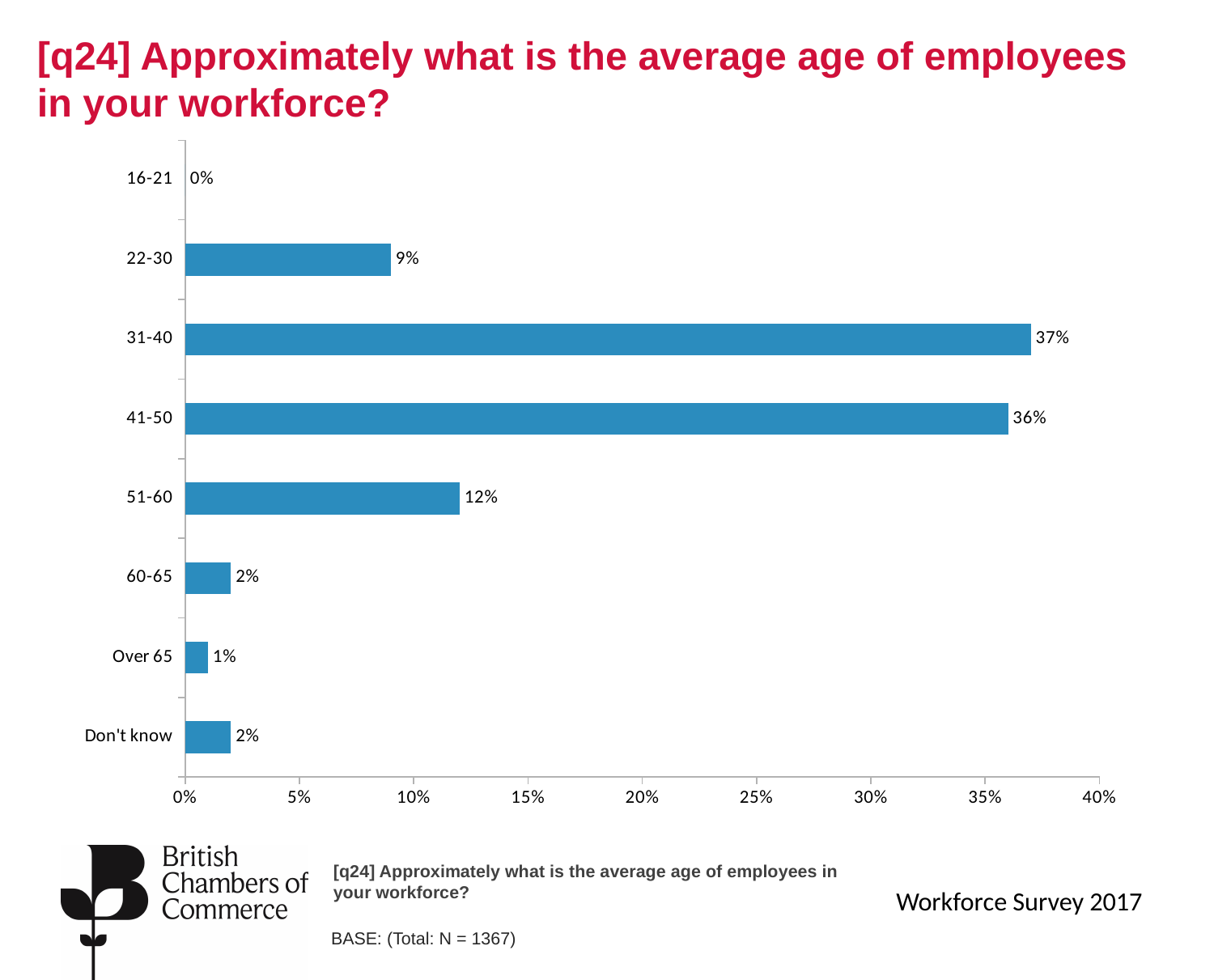
Which age category has the lowest percentage? 16-21 How many categories are shown on the chart? 8 Which age category has the highest percentage? 31-40 What value is shown for 'Over 65'? 1% What is the difference between the percentages for 51-60 and 22-30? 3% Is the value for 41-50 greater or less than 35%? greater What is the difference between the percentages for 31-40 and 41-50? 1% What is the value shown for the 51-60 age category? 12% What kind of chart is shown on the slide? Bar chart What percentage of respondents said the average age of employees in their workforce is 31-40? 37% Which is larger, the value for 22-30 or the value for 51-60? 51-60 What percentage is shown for the 22-30 category? 9%